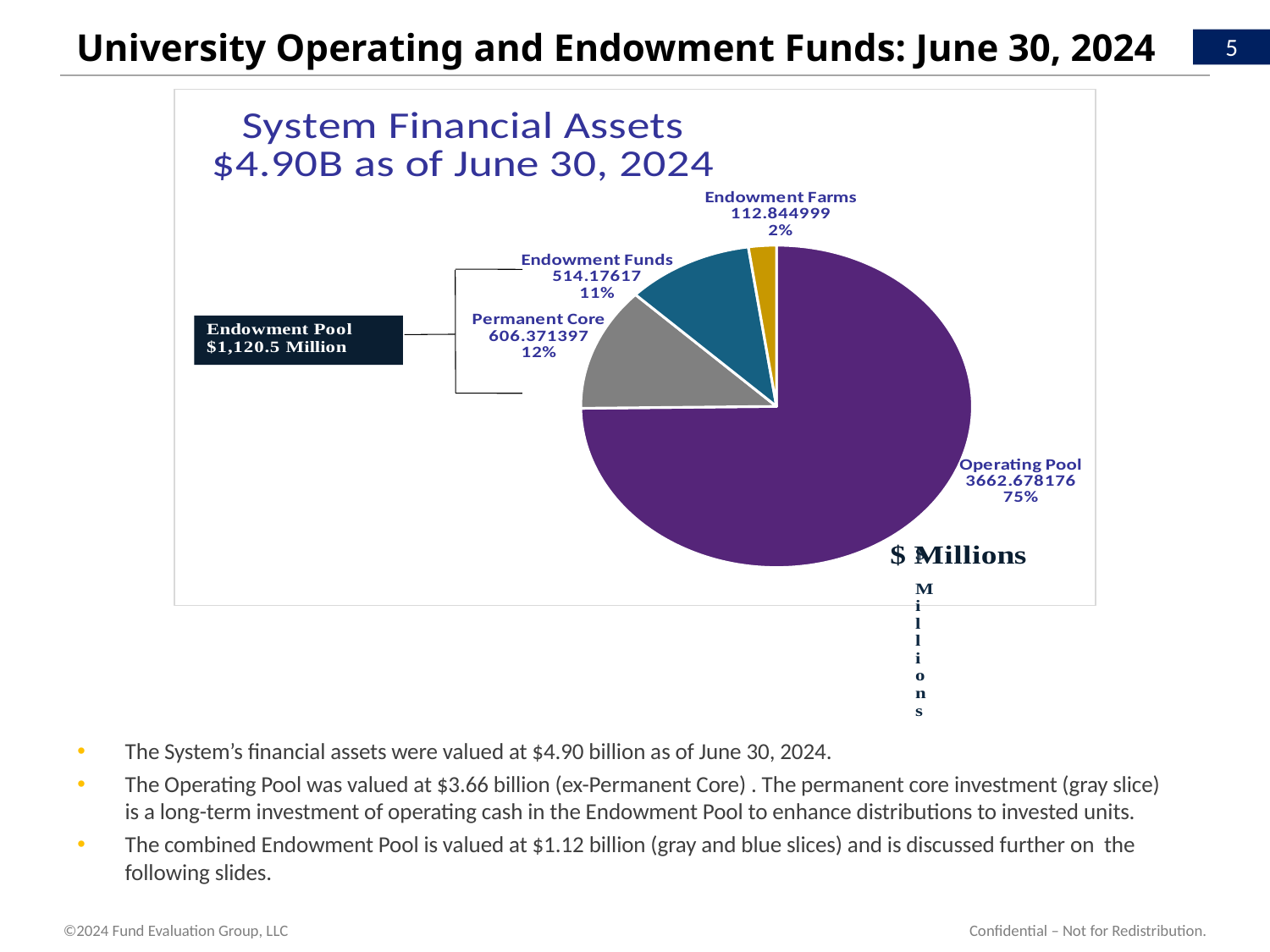
What is the value shown for the Endowment Funds slice? 514.17617 Which is larger, the Permanent Core slice or the Endowment Funds slice? Permanent Core Which slice is the largest in the pie chart? Operating Pool How many slices does the pie chart have? 4 What percentage share of the pie does the Operating Pool represent? 75% Which slice is the smallest in the pie chart? Endowment Farms What is the title of the chart? System Financial Assets $4.90B as of June 30, 2024 What is the value shown for the Permanent Core slice? 606.371397 What is the value shown for the Endowment Farms slice? 112.844999 What percentage share of the pie does Endowment Funds represent? 11% What is the value shown for the Operating Pool slice? 3662.678176 What type of chart is shown on the slide? Pie chart